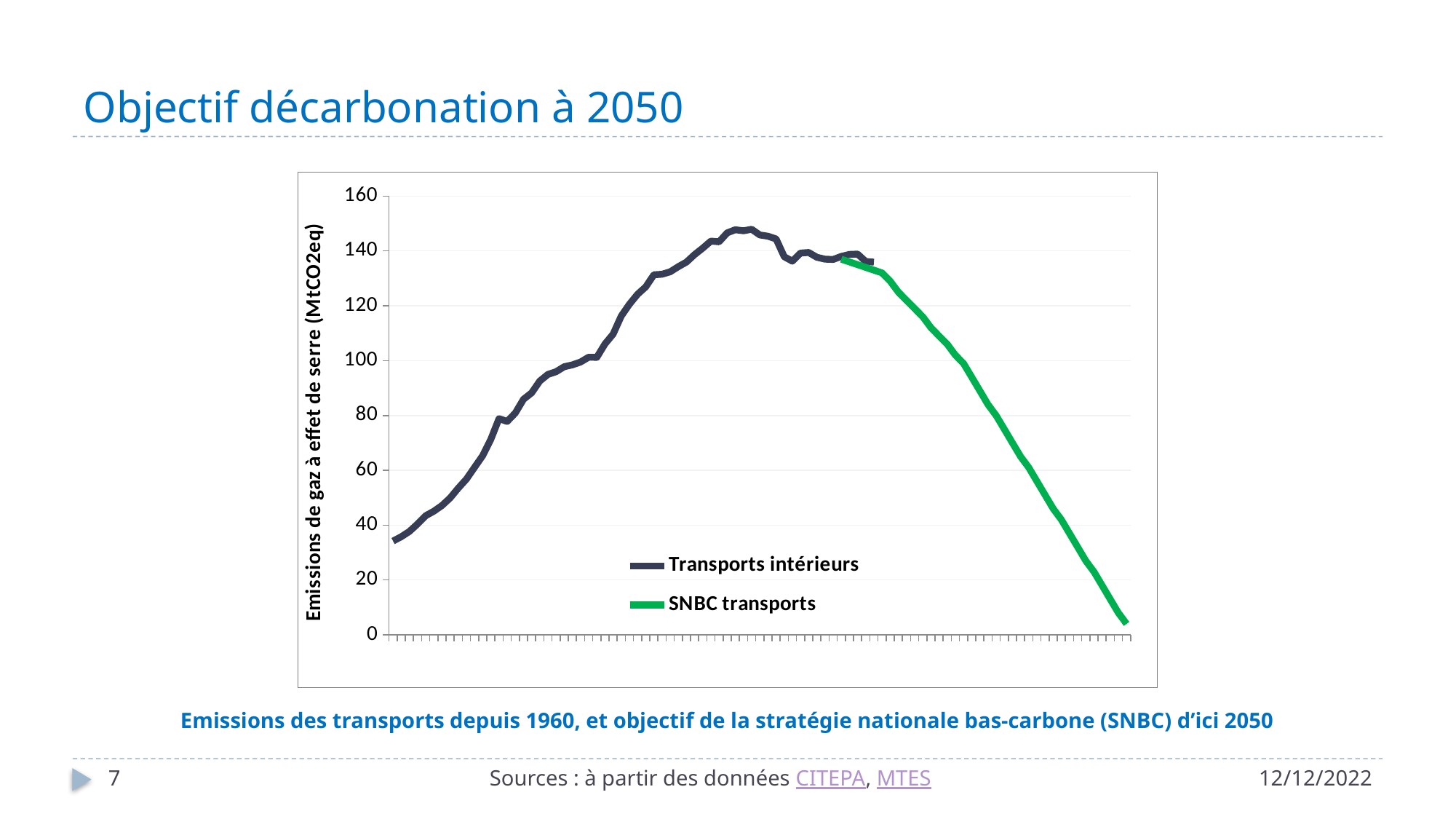
Does the SNBC transports line rise or fall along the x axis? falls What is the highest tick value shown on the vertical axis? 160 Is the highest value reached by the Transports intérieurs line greater or less than 140? greater Is the first value of the Transports intérieurs line greater or less than 40? less What is the title of the vertical axis? Emissions de gaz à effet de serre (MtCO2eq) What kind of chart is shown on the slide? line chart How many series does the legend list? 2 What are the two series named in the legend? Transports intérieurs and SNBC transports Which series reaches the highest value on the chart? Transports intérieurs Is the final value of the SNBC transports line greater or less than 20? less Which series reaches the lowest value on the chart? SNBC transports